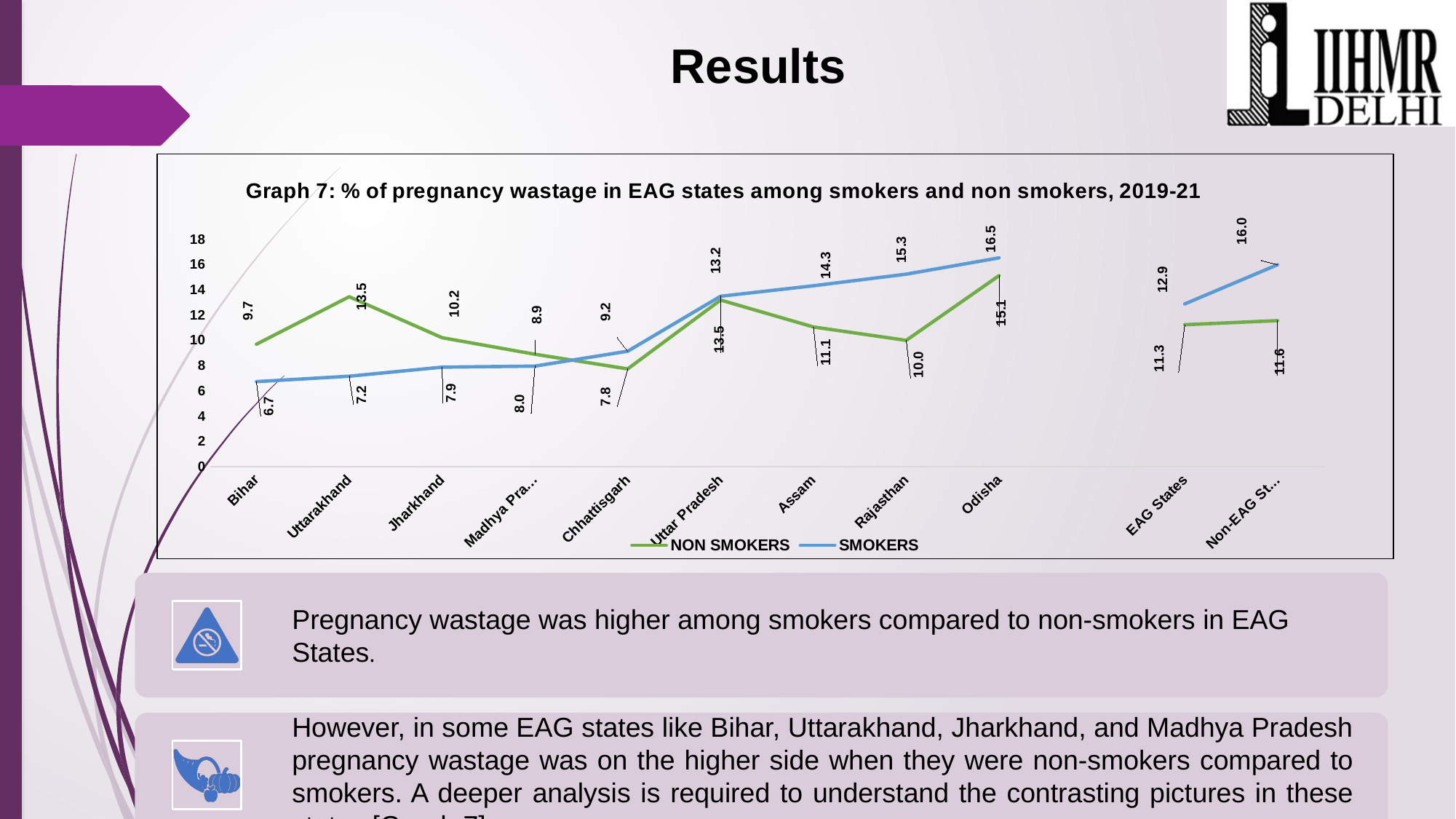
What is the difference between the smokers and non-smokers values in Rajasthan? 5.3 Which category has the lowest value for smokers? Bihar How many categories are shown on the x axis? 11 What type of chart is shown on the slide? Line chart What is the value for smokers in Rajasthan? 15.3 In Uttarakhand, which is larger: the value for smokers or for non-smokers? Non-smokers Which category has the lowest value for non-smokers? Chhattisgarh What is the value for non-smokers in EAG States? 11.3 What is the pregnancy wastage value for non-smokers in Uttarakhand? 13.5 Which category has the highest value for smokers? Odisha How many series does the legend list? 2 What is the pregnancy wastage value for smokers in Bihar? 6.7